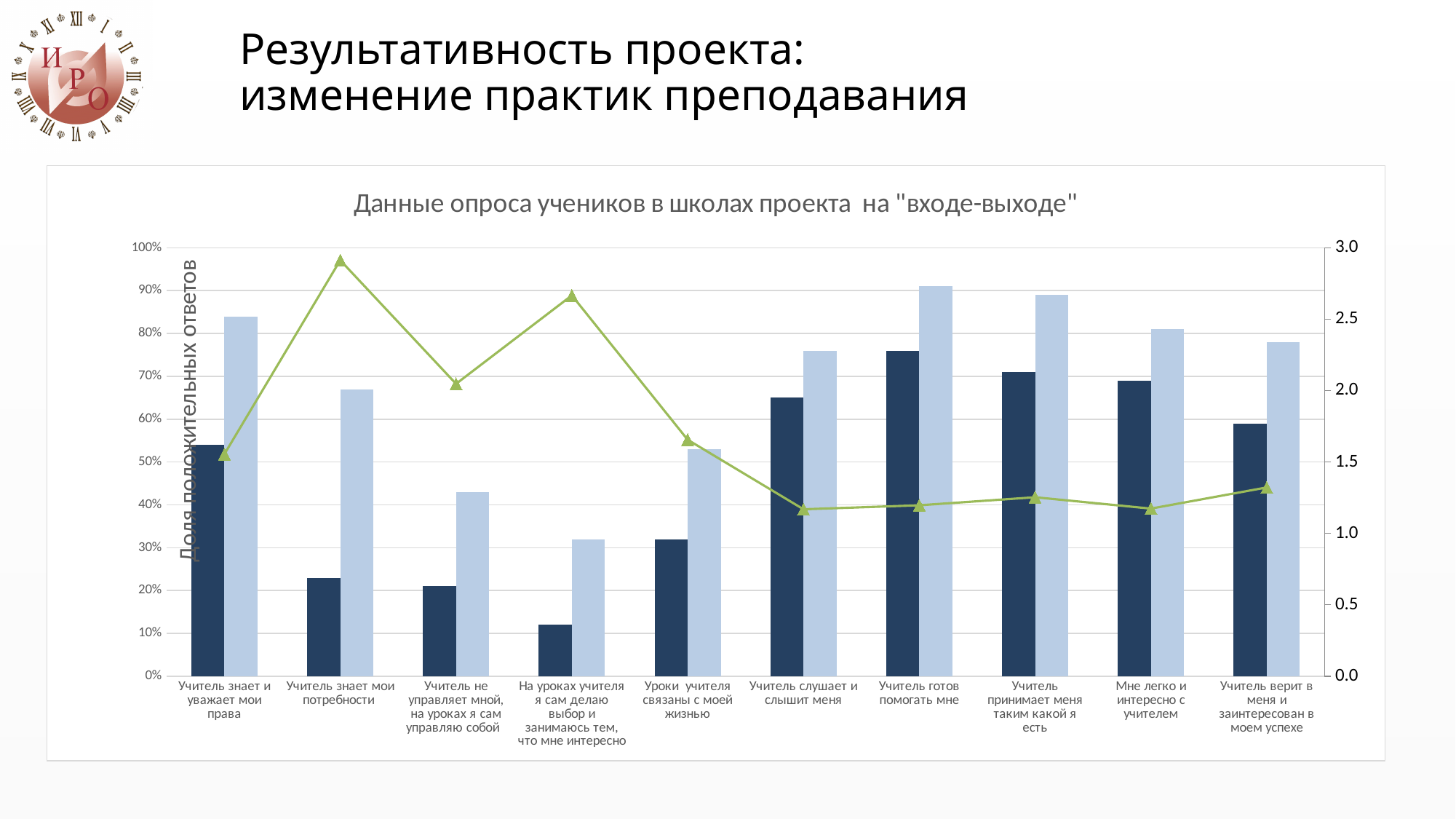
Which is taller: the dark blue bar for "Учитель слушает и слышит меня" or the dark blue bar for "Уроки учителя связаны с моей жизнью"? Учитель слушает и слышит меня What kind of chart is shown on the slide? bar chart with a line series At which category does the green line reach its highest point? Учитель знает мои потребности Is the dark blue bar for "Учитель не управляет мной, на уроках я сам управляю собой" greater or less than 30%? less Which category has the highest dark blue bar? Учитель готов помогать мне Is the light blue bar for "Учитель знает мои потребности" greater or less than 60%? greater Which category has the lowest dark blue bar? На уроках учителя я сам делаю выбор и занимаюсь тем, что мне интересно For "Учитель знает и уважает мои права", which bar is taller, the dark blue or the light blue one? light blue How many categories are shown along the x axis of the chart? 10 What is the title of the chart? Данные опроса учеников в школах проекта на "входе-выходе" Is the green line value for "Учитель знает мои потребности" greater or less than 2.5 on the right axis? greater Which category has the lowest light blue bar? На уроках учителя я сам делаю выбор и занимаюсь тем, что мне интересно